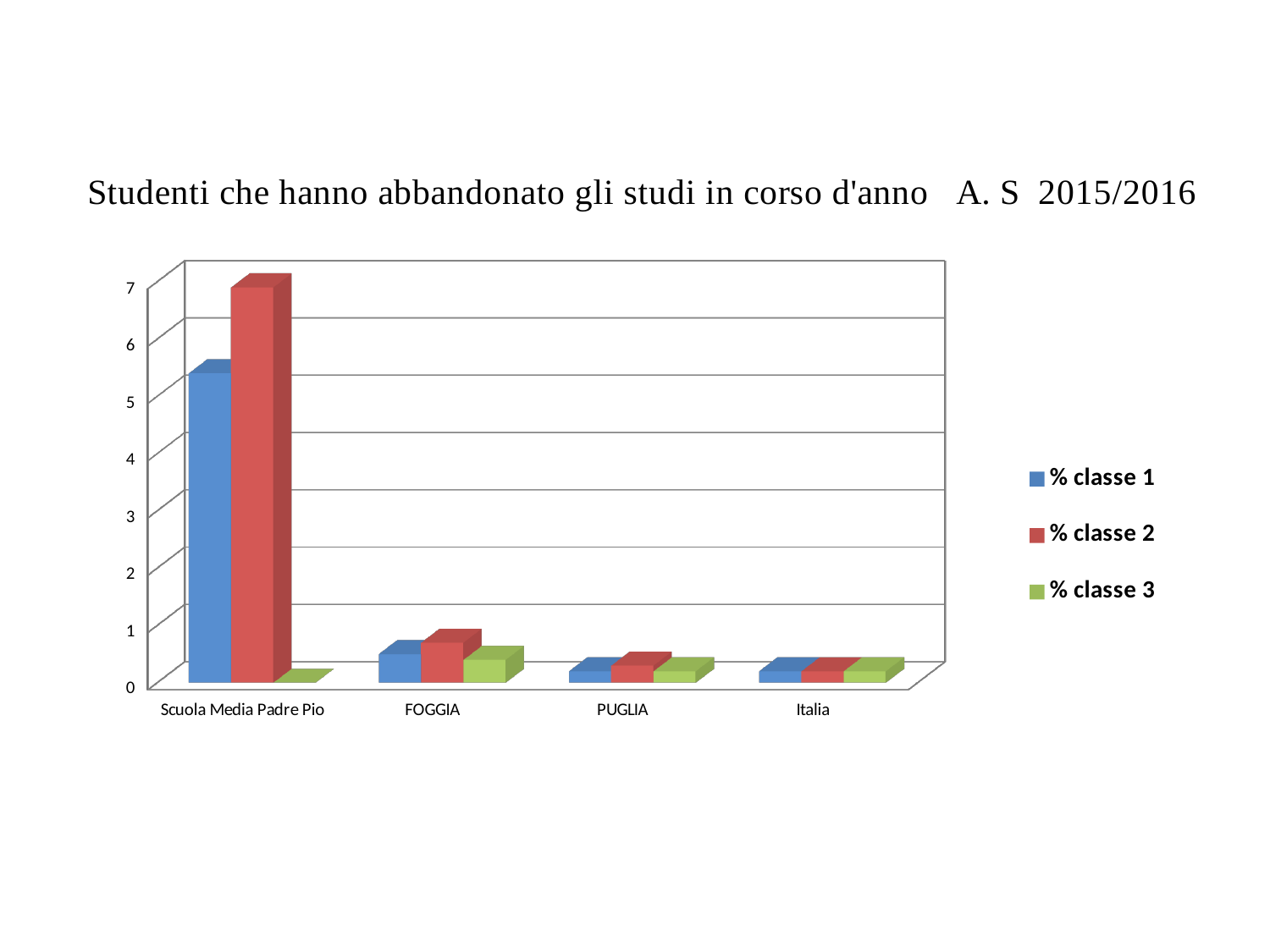
How many series does the legend list? 3 What is the title of the chart? Studenti che hanno abbandonato gli studi in corso d'anno A. S 2015/2016 Which colour represents % classe 3 in the legend? green Which category has the highest value for % classe 2? Scuola Media Padre Pio Which category has the highest value for % classe 1? Scuola Media Padre Pio Is the value for % classe 1 at Scuola Media Padre Pio greater or less than 4? greater At Scuola Media Padre Pio, which is larger: % classe 1 or % classe 2? % classe 2 Is the value for % classe 2 at FOGGIA greater or less than 1? less Is the value for % classe 2 at Scuola Media Padre Pio greater or less than 6? greater What kind of chart is shown on the slide? bar chart How many categories are shown on the x axis of the chart? 4 For % classe 1, which is larger: Scuola Media Padre Pio or Italia? Scuola Media Padre Pio